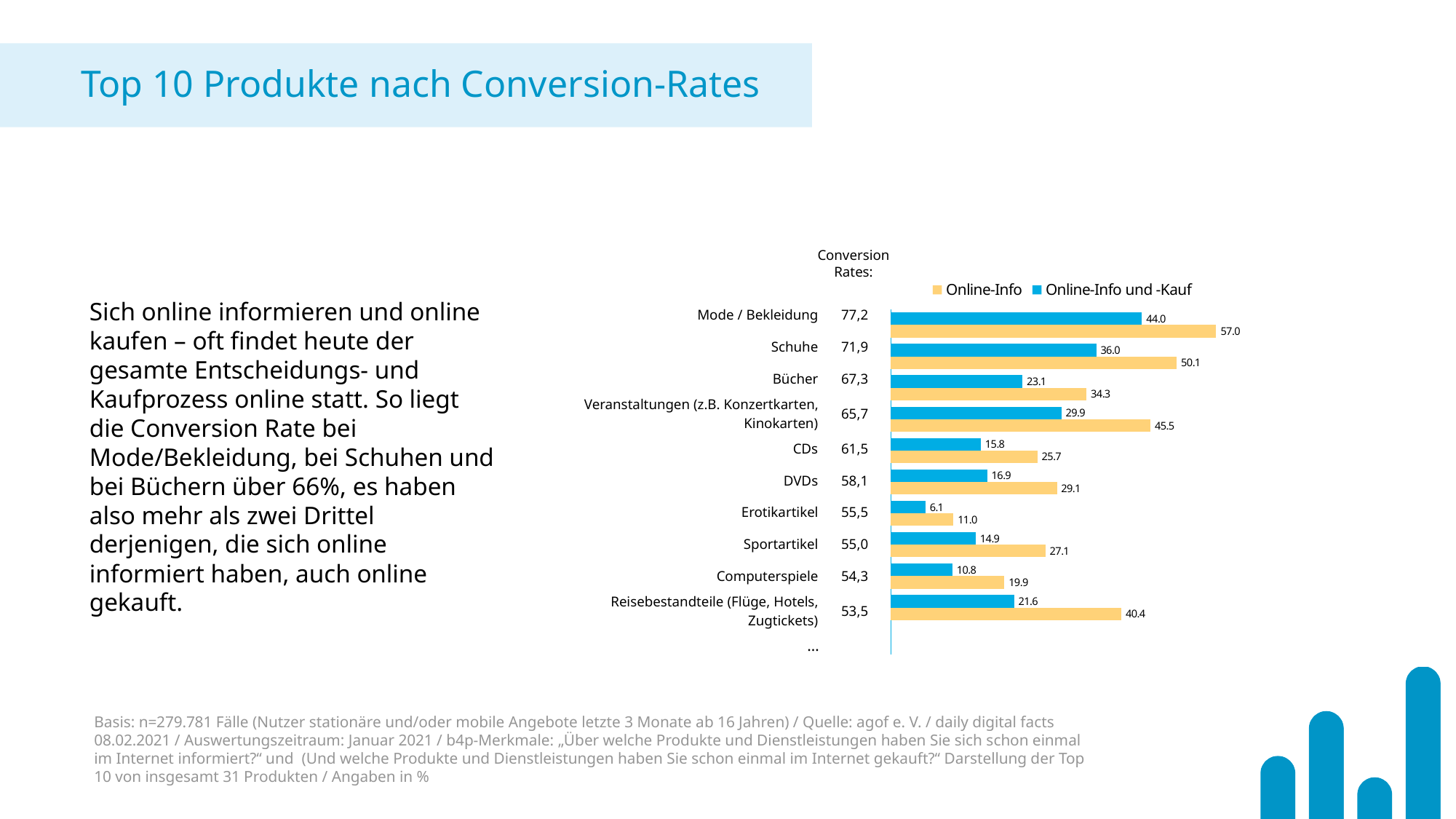
What is the Online-Info value for Mode / Bekleidung? 57.0 What kind of chart is shown on the slide? Bar chart Which product category has the highest Online-Info und -Kauf value? Mode / Bekleidung Which colour represents the Online-Info und -Kauf series? Blue How many series does the legend list? 2 What is the Online-Info value for Reisebestandteile (Flüge, Hotels, Zugtickets)? 40.4 How many product categories have bars plotted in the chart? 10 What is the Online-Info und -Kauf value for Schuhe? 36.0 What is the difference between the Online-Info and the Online-Info und -Kauf values for Bücher? 11.2 Which is larger: the Online-Info value for DVDs or the Online-Info value for CDs? DVDs What is the Online-Info und -Kauf value for Erotikartikel? 6.1 Which product category has the lowest Online-Info value? Erotikartikel